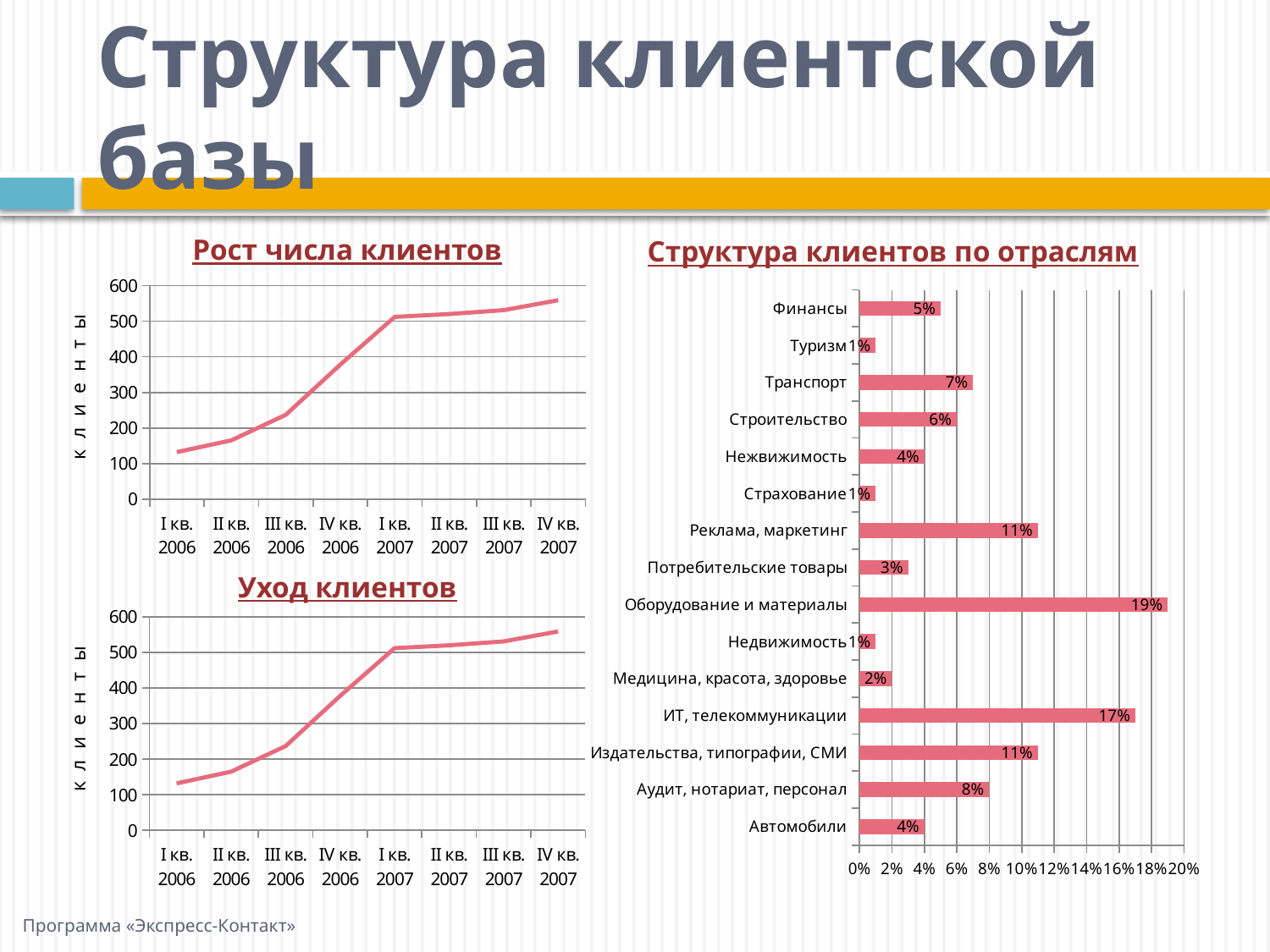
What kind of chart is "Рост числа клиентов"? line chart In the chart titled "Структура клиентов по отраслям", what is the difference between Оборудование и материалы and ИТ, телекоммуникации? 2% In the chart titled "Структура клиентов по отраслям", what is the value for Финансы? 5% In the chart titled "Структура клиентов по отраслям", what is the value for ИТ, телекоммуникации? 17% How many categories are shown in the chart titled "Структура клиентов по отраслям"? 15 In the chart titled "Структура клиентов по отраслям", which is larger: Транспорт or Строительство? Транспорт In the chart titled "Структура клиентов по отраслям", what is the value for Аудит, нотариат, персонал? 8% What kind of chart is "Структура клиентов по отраслям"? bar chart In the chart titled "Рост числа клиентов", is the value for I кв. 2006 greater or less than 200? less In the chart titled "Структура клиентов по отраслям", which category has the highest value? Оборудование и материалы In the chart titled "Уход клиентов", is the value for IV кв. 2007 greater or less than 500? greater In the chart titled "Рост числа клиентов", do the values rise or fall from I кв. 2006 to IV кв. 2007? rise